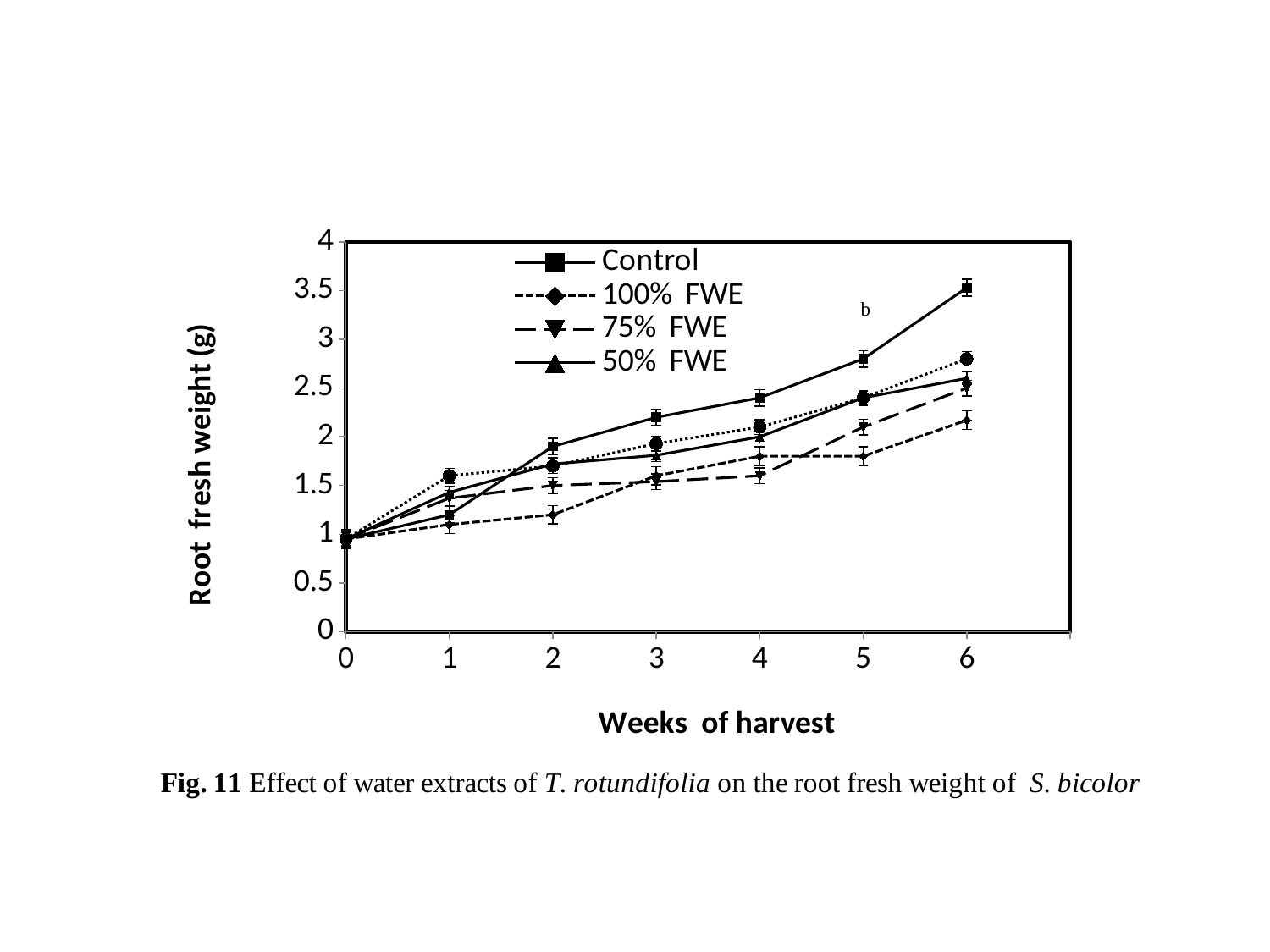
What is the title of the y axis? Root fresh weight (g) Is the value for Control at week 6 greater or less than 3? greater Which series has the highest root fresh weight at week 6? Control Which series has the lowest root fresh weight at week 6? 100% FWE Is the value for 100% FWE at week 5 greater or less than 2? less Is the value for 100% FWE at week 2 greater or less than 1.5? less How many series does the legend list? 4 How many weeks of harvest are plotted along the x axis? 7 What kind of chart is shown on the slide? line chart Does the root fresh weight for Control rise or fall from week 0 to week 6? rise Which is larger at week 6, the value for Control or the value for 100% FWE? Control